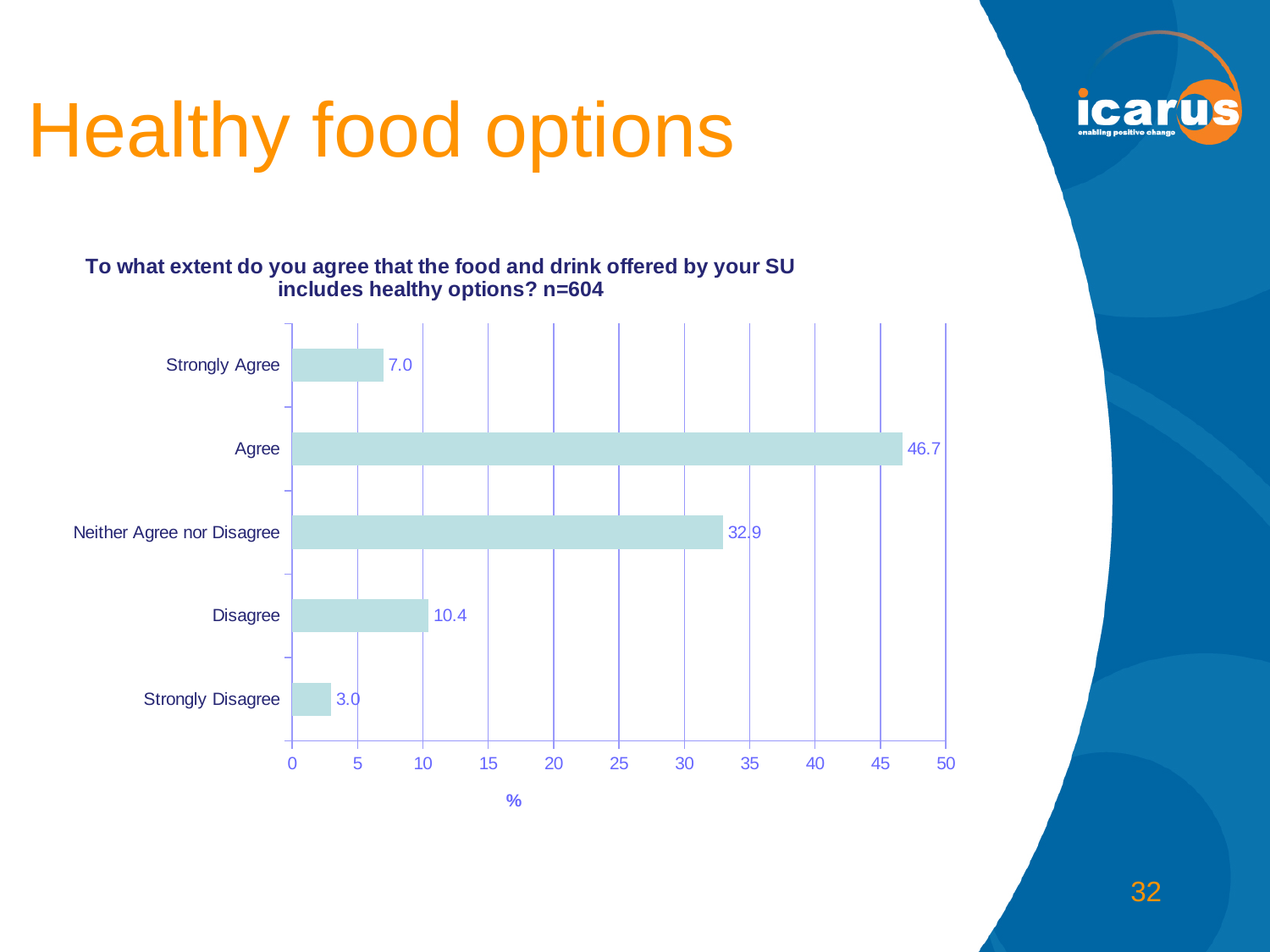
What is the value for Neither Agree nor Disagree? 32.9 What is the value for Agree? 46.7 What is the difference between the values for Agree and Neither Agree nor Disagree? 13.8 Which is larger, the value for Strongly Agree or the value for Disagree? Disagree What is the sample size (n) stated in the chart title? 604 What kind of chart is shown on the slide? Bar chart Which category has the lowest value? Strongly Disagree Which category has the highest value? Agree What is the value for Strongly Disagree? 3.0 How many categories are shown on the chart? 5 What is the value for Disagree? 10.4 Is the value for Agree greater or less than 45? greater